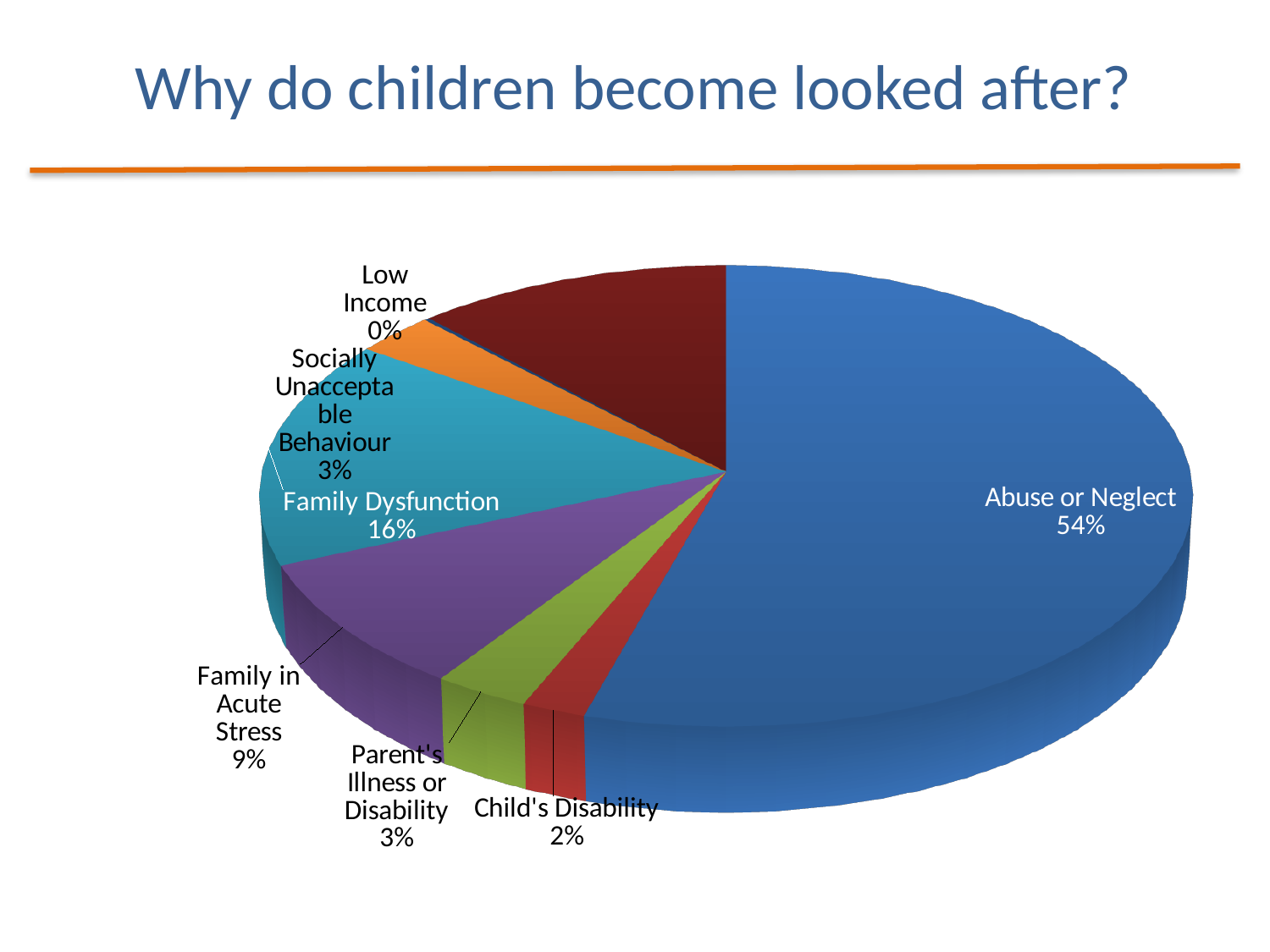
What percentage of the pie is Abuse or Neglect? 54% What is the title of the slide containing the chart? Why do children become looked after? What percentage is shown for Low Income? 0% Which is larger, Family in Acute Stress or Socially Unacceptable Behaviour? Family in Acute Stress What percentage is shown for Family Dysfunction? 16% What type of chart is shown on the slide? pie chart What percentage is shown for Parent's Illness or Disability? 3% What is the difference in percentage points between Abuse or Neglect and Family Dysfunction? 38 What percentage is shown for Child's Disability? 2% What percentage is shown for Family in Acute Stress? 9% Which labelled category has the smallest share of the pie? Low Income Which labelled category has the largest share of the pie? Abuse or Neglect